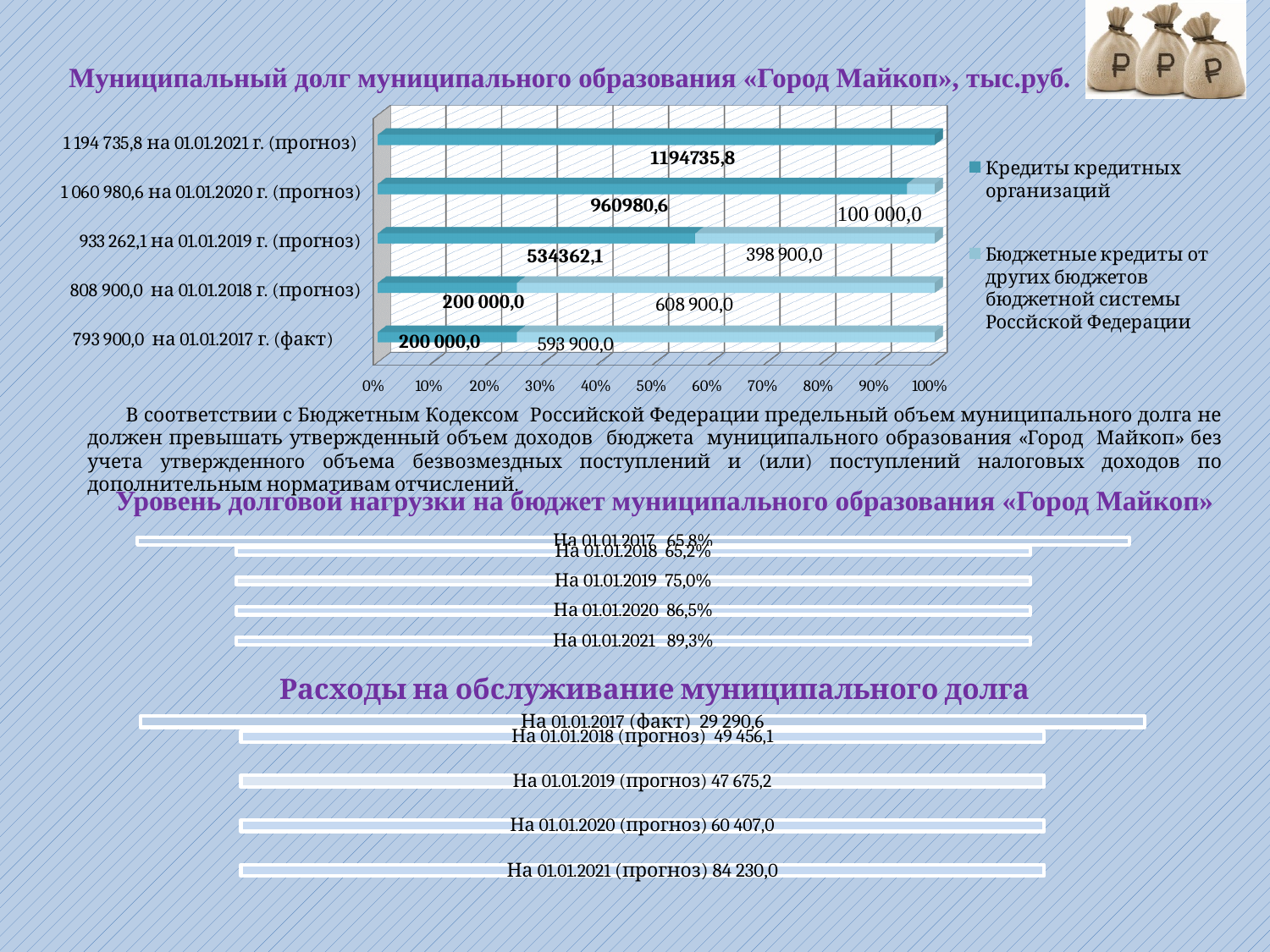
In the municipal debt chart, what is the value of «Кредиты кредитных организаций» for 01.01.2021 г. (прогноз)? 1194735,8 What kind of chart is used to show the municipal debt of «Город Майкоп»? bar chart In the municipal debt chart, what is the value of «Бюджетные кредиты от других бюджетов бюджетной системы Российской Федерации» for 01.01.2020 г. (прогноз)? 100 000,0 What is the title of the chart at the top of the slide? Муниципальный долг муниципального образования «Город Майкоп», тыс.руб. How many series does the legend of the municipal debt chart list? 2 In the municipal debt chart, which is larger for 01.01.2019 г. (прогноз): «Кредиты кредитных организаций» or «Бюджетные кредиты от других бюджетов»? Кредиты кредитных организаций In the municipal debt chart, what is the difference between the «Бюджетные кредиты» values for 01.01.2018 г. (прогноз) and 01.01.2017 г. (факт)? 15 000,0 In the municipal debt chart, what is the value of «Бюджетные кредиты от других бюджетов бюджетной системы Российской Федерации» for 01.01.2017 г. (факт)? 593 900,0 In the municipal debt chart, for which date is the value of «Бюджетные кредиты от других бюджетов бюджетной системы Российской Федерации» the highest? 01.01.2018 г. (прогноз) How many categories (dates) are shown on the municipal debt chart? 5 In the municipal debt chart, what is the value of «Кредиты кредитных организаций» for 01.01.2019 г. (прогноз)? 534362,1 In the municipal debt chart, for which date is the value of «Кредиты кредитных организаций» the highest? 01.01.2021 г. (прогноз)